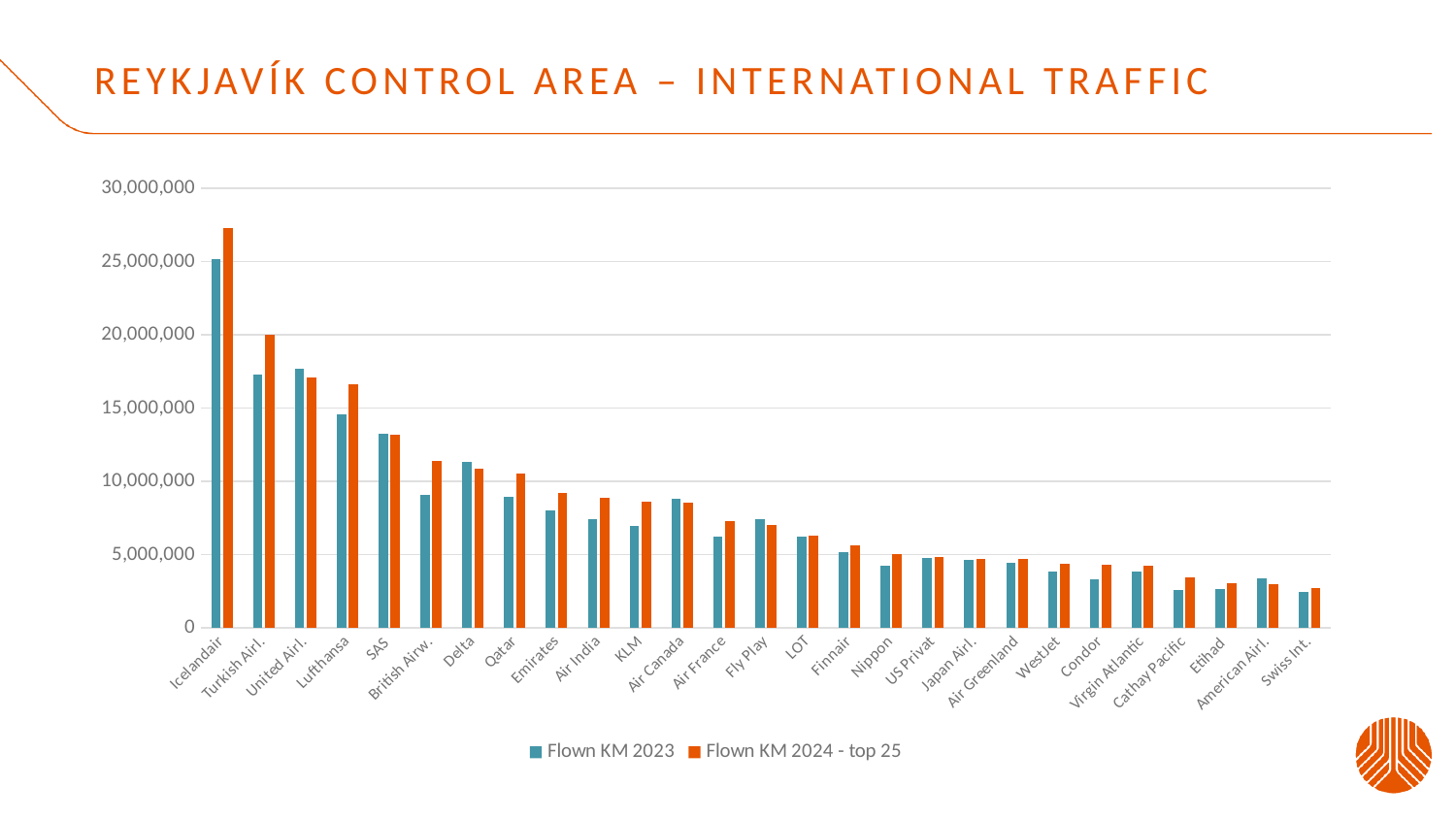
Is the Flown KM 2024 value for Icelandair greater or less than 25,000,000? greater Is the Flown KM 2024 value for British Airw. greater or less than 10,000,000? greater Which airline has the highest Flown KM 2024 value? Icelandair What kind of chart is shown on the slide? Bar chart Which airline has the lowest Flown KM 2024 value? Swiss Int. How many series does the legend list? 2 For United Airl., which is larger: Flown KM 2023 or Flown KM 2024? Flown KM 2023 How many airlines (categories) are shown on the x axis? 27 Is the Flown KM 2023 value for Turkish Airl. greater or less than 20,000,000? less For Qatar, which is larger: Flown KM 2023 or Flown KM 2024? Flown KM 2024 Do the values generally rise or fall moving from left to right along the x axis? Fall